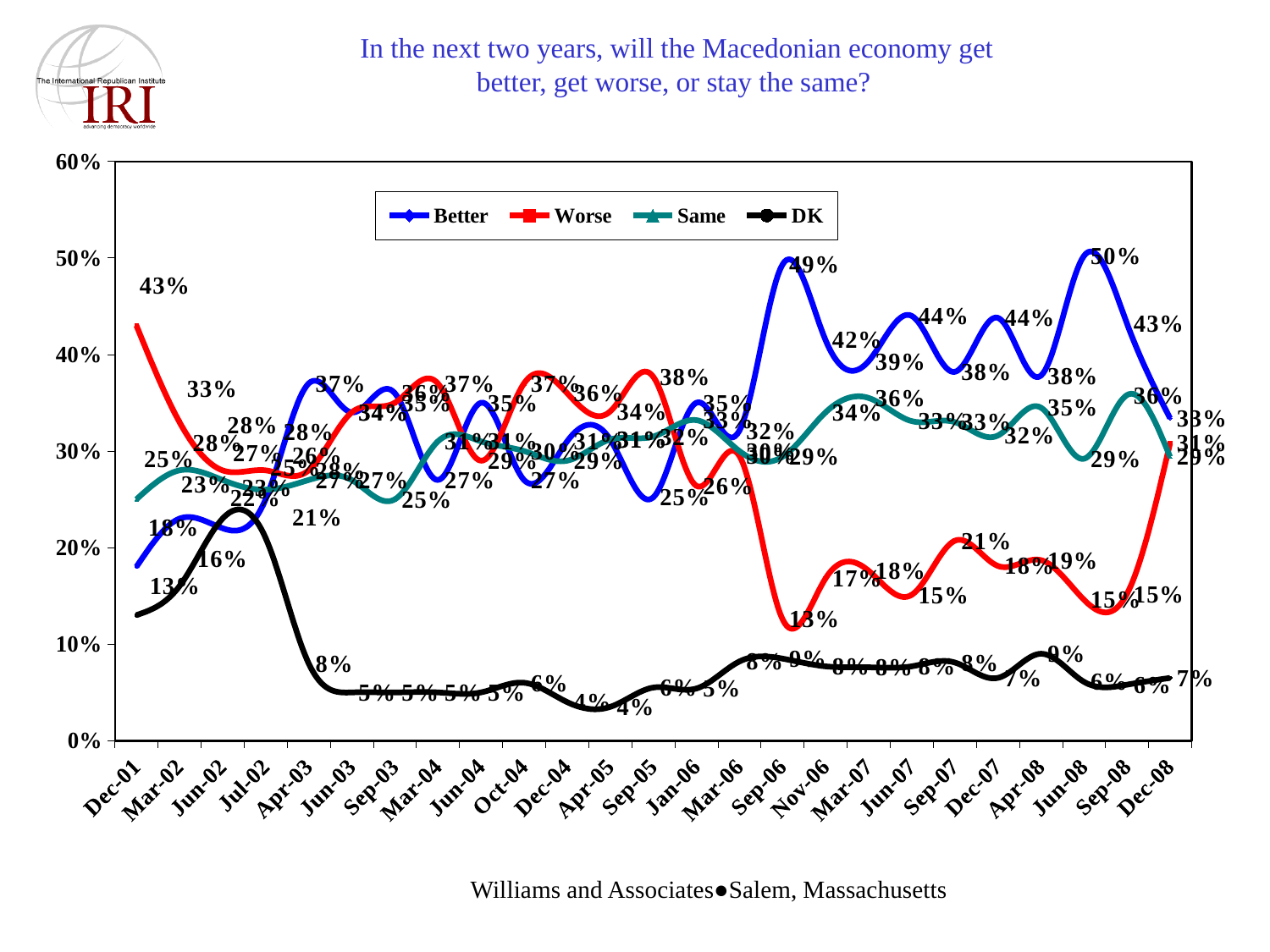
What kind of chart is shown on the slide? line chart Does the Worse series rise or fall from Dec-01 to Apr-03? fall How many series does the legend list? 4 What is the value for Better in Dec-08? 33% What is the value for DK in Dec-01? 13% What is the value for Worse in Sep-06? 13% What is the value for Better in Sep-06? 49% In Dec-08, how much higher is Better (33%) than Worse (31%)? 2 percentage points In which period does the Better series reach its highest value? Jun-08 What are the four series named in the legend? Better, Worse, Same, DK In Dec-01, which is larger: Worse or Better? Worse What is the value for Worse in Dec-01? 43%